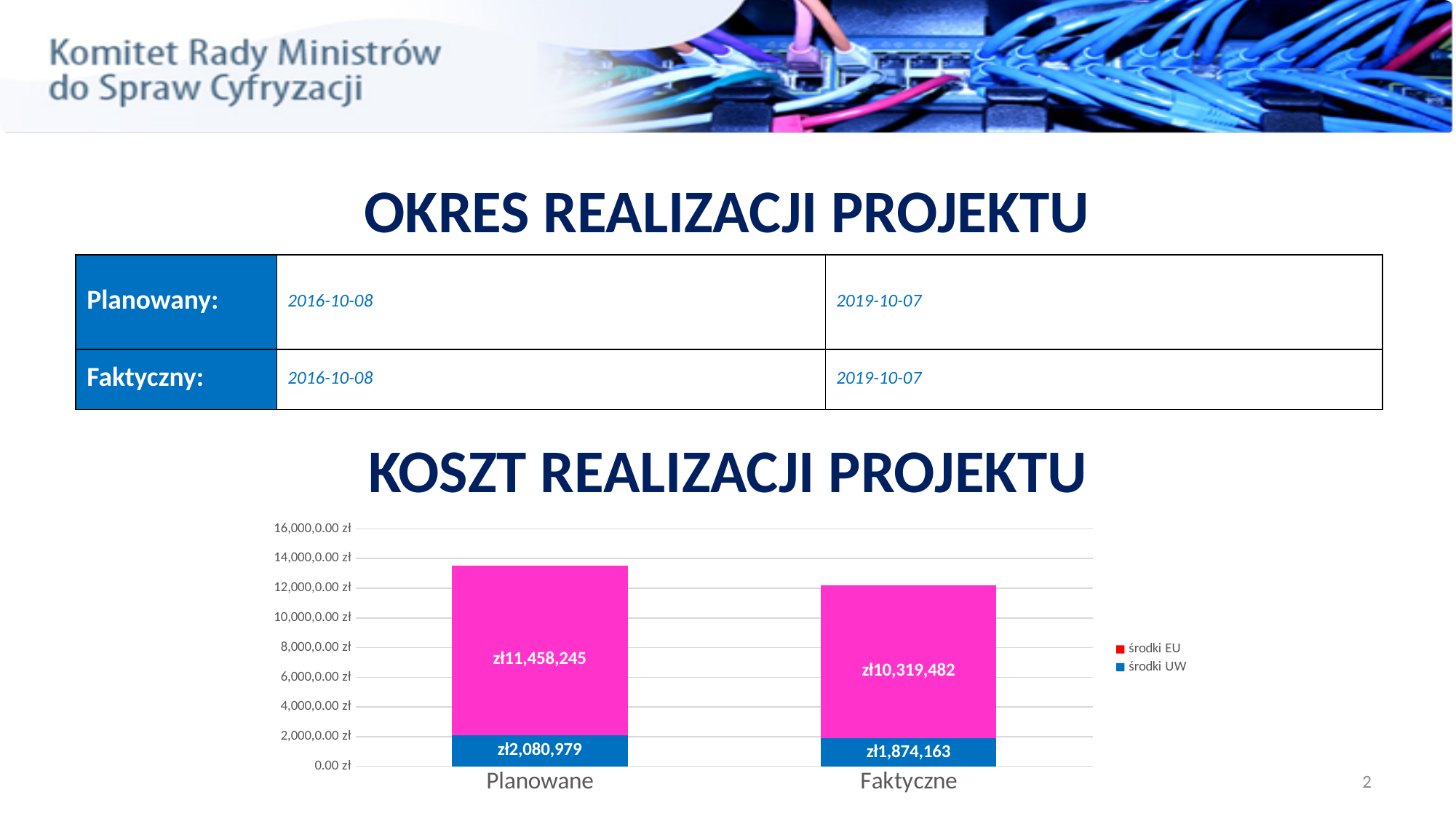
What kind of chart is shown under KOSZT REALIZACJI PROJEKTU? Stacked bar chart What is the difference between środki EU for Planowane and środki EU for Faktyczne? zł1,138,763 What are the two series named in the chart legend? środki EU and środki UW What is the total of the stacked bar for Faktyczne? zł12,193,645 Which category has the larger środki UW value, Planowane or Faktyczne? Planowane What is the value of środki UW for Planowane? zł2,080,979 How many categories are shown on the x axis of the chart? 2 What is the value of środki EU for Planowane? zł11,458,245 What is the value of środki UW for Faktyczne? zł1,874,163 What is the value of środki EU for Faktyczne? zł10,319,482 How many series does the chart legend list? 2 What is the total of the stacked bar for Planowane? zł13,539,224